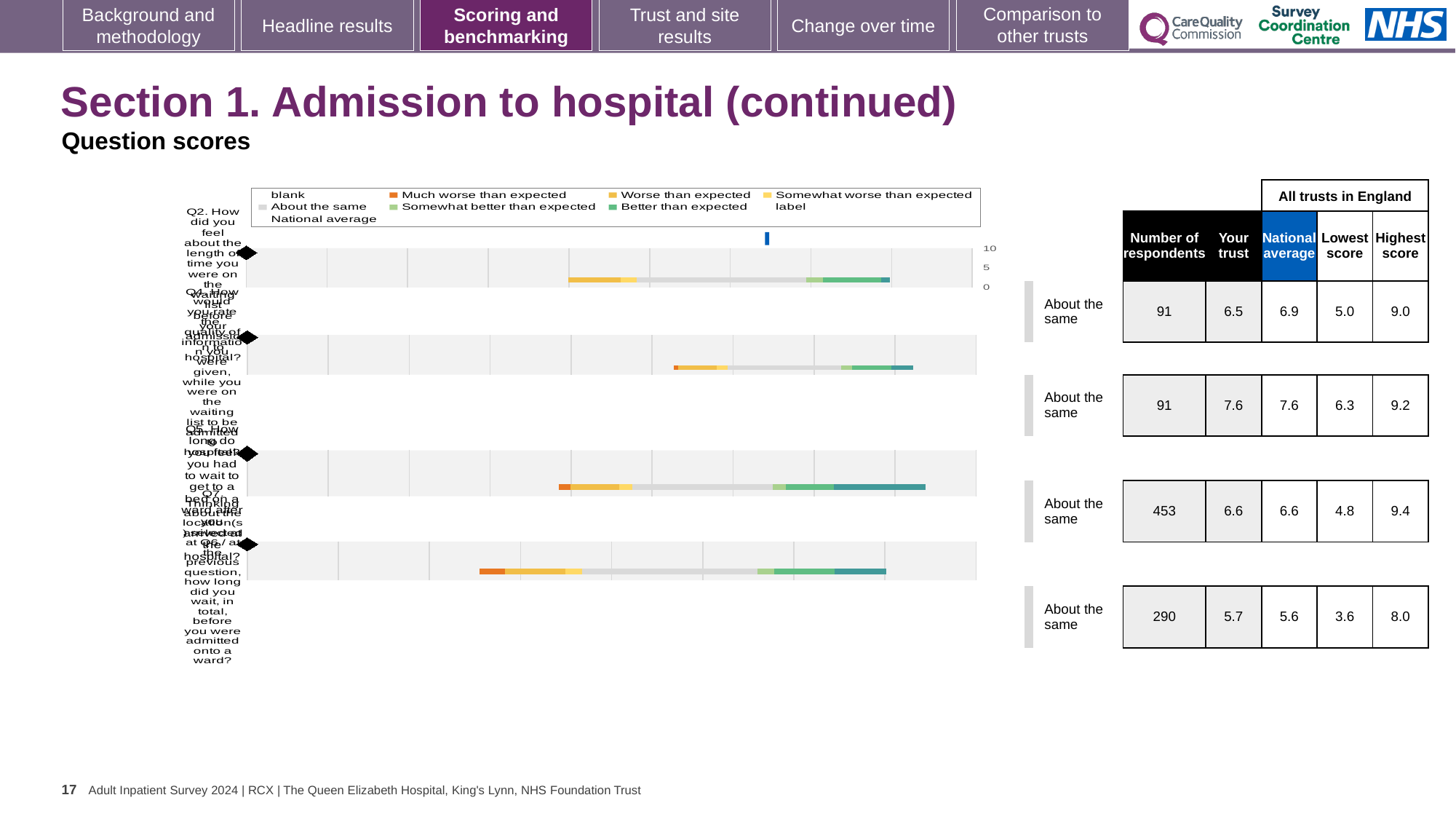
In the table beside the chart, what is the difference between the highest score and the lowest score for the third row (Q5)? 4.6 What kind of chart is shown on the slide? bar chart How many question rows (bars) are plotted in the chart? 4 In the table beside the chart, what is the highest score for the third row (Q5)? 9.4 In the table beside the chart, what is the number of respondents for the top row (Q2)? 91 In the table beside the chart, what is the 'Your trust' score for the top row (Q2)? 6.5 In the table beside the chart, what is the lowest score for the bottom row? 3.6 For the bottom row, is the 'Your trust' score (5.7) larger or smaller than the national average (5.6)? larger What is the maximum value shown on the chart's score axis? 10 Which row in the table beside the chart has the largest number of respondents? the third row (Q5), 453 In the table beside the chart, what is the national average for the second row (Q4)? 7.6 Which colour in the legend represents 'About the same'? grey